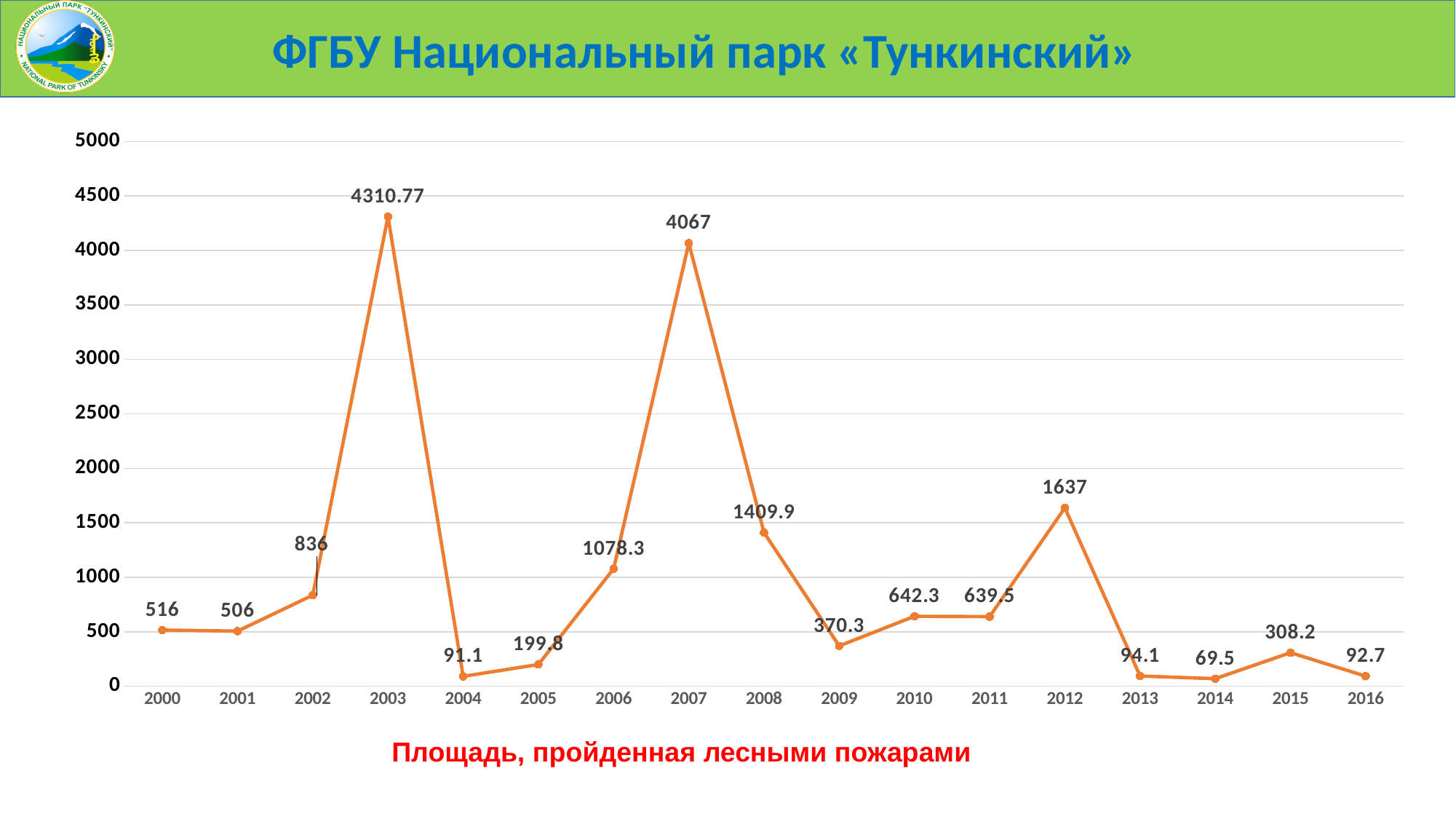
How many years are plotted on the x axis? 17 What is the caption below the chart? Площадь, пройденная лесными пожарами Is the value for 2009 greater or less than 500? less What is the value for 2003? 4310.77 What is the value for 2014? 69.5 What is the difference between the values for 2003 and 2007? 243.77 What is the value for 2008? 1409.9 Which is larger, the value for 2006 or the value for 2012? 2012 What kind of chart is shown? line chart Which year has the highest value? 2003 Do the values rise or fall from 2012 to 2014? fall Which year has the lowest value? 2014